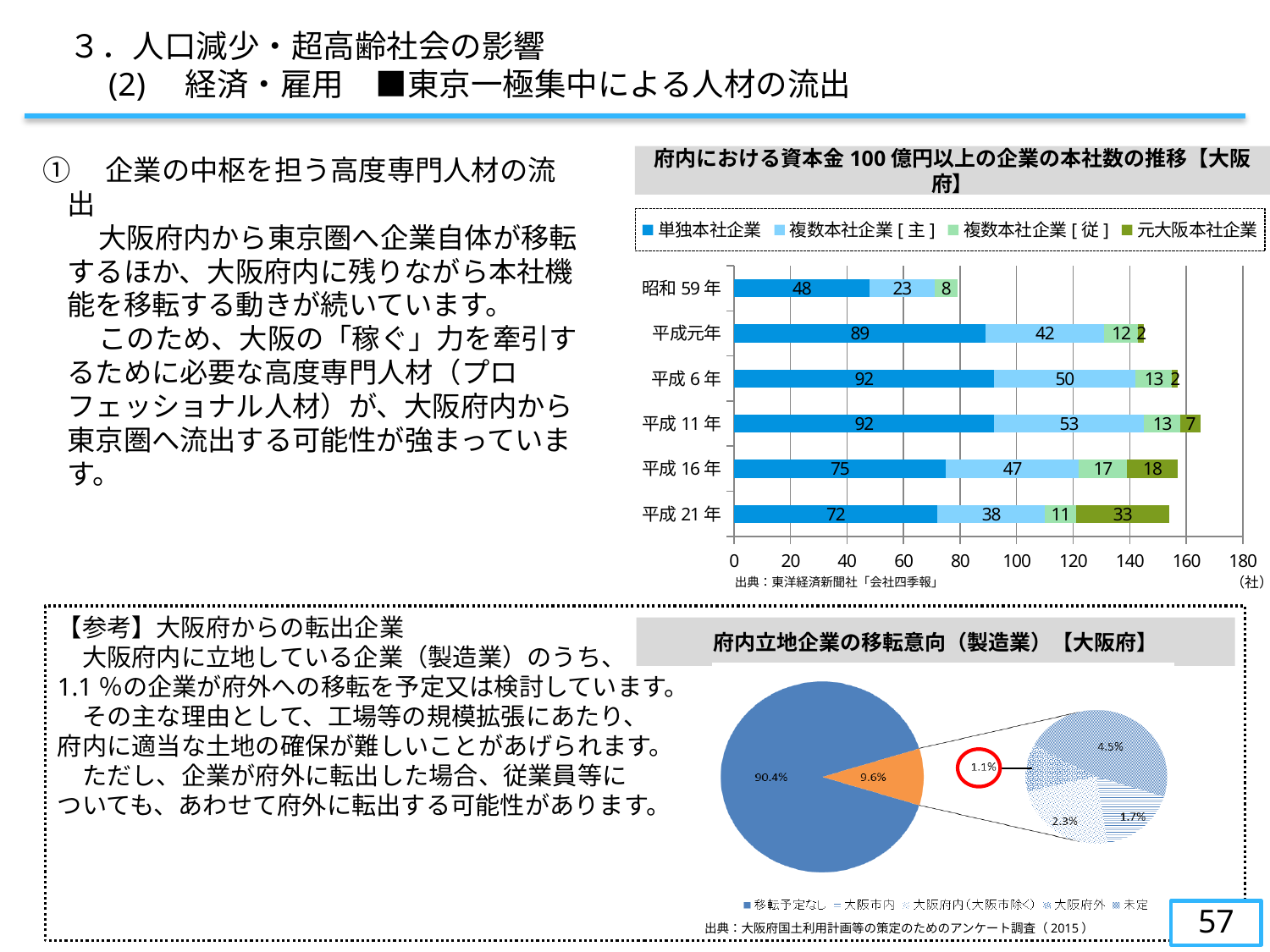
In the top-right bar chart, what is the value of 単独本社企業 for 平成21年? 72 How many years (categories) are shown in the top-right bar chart? 6 In the top-right bar chart, which year has the highest value for 元大阪本社企業? 平成21年 In the top-right bar chart, is the 複数本社企業[主] value for 平成元年 larger than that for 平成16年? No, 平成16年 is larger (47 vs 42) What kind of chart is the chart titled 府内立地企業の移転意向（製造業）【大阪府】? Pie chart In the top-right bar chart, what is the value of 元大阪本社企業 for 平成16年? 18 How many series does the legend of the top-right bar chart list? 4 In the top-right bar chart, what is the total of the stacked bar for 平成11年? 165 In the top-right bar chart, what is the value of 複数本社企業[主] for 平成11年? 53 In the bottom-right pie chart, what is the share of the largest slice? 90.4% In the top-right bar chart, which year has the lowest value for 単独本社企業? 昭和59年 In the top-right bar chart, what is the difference between the 単独本社企業 values for 平成6年 and 平成21年? 20